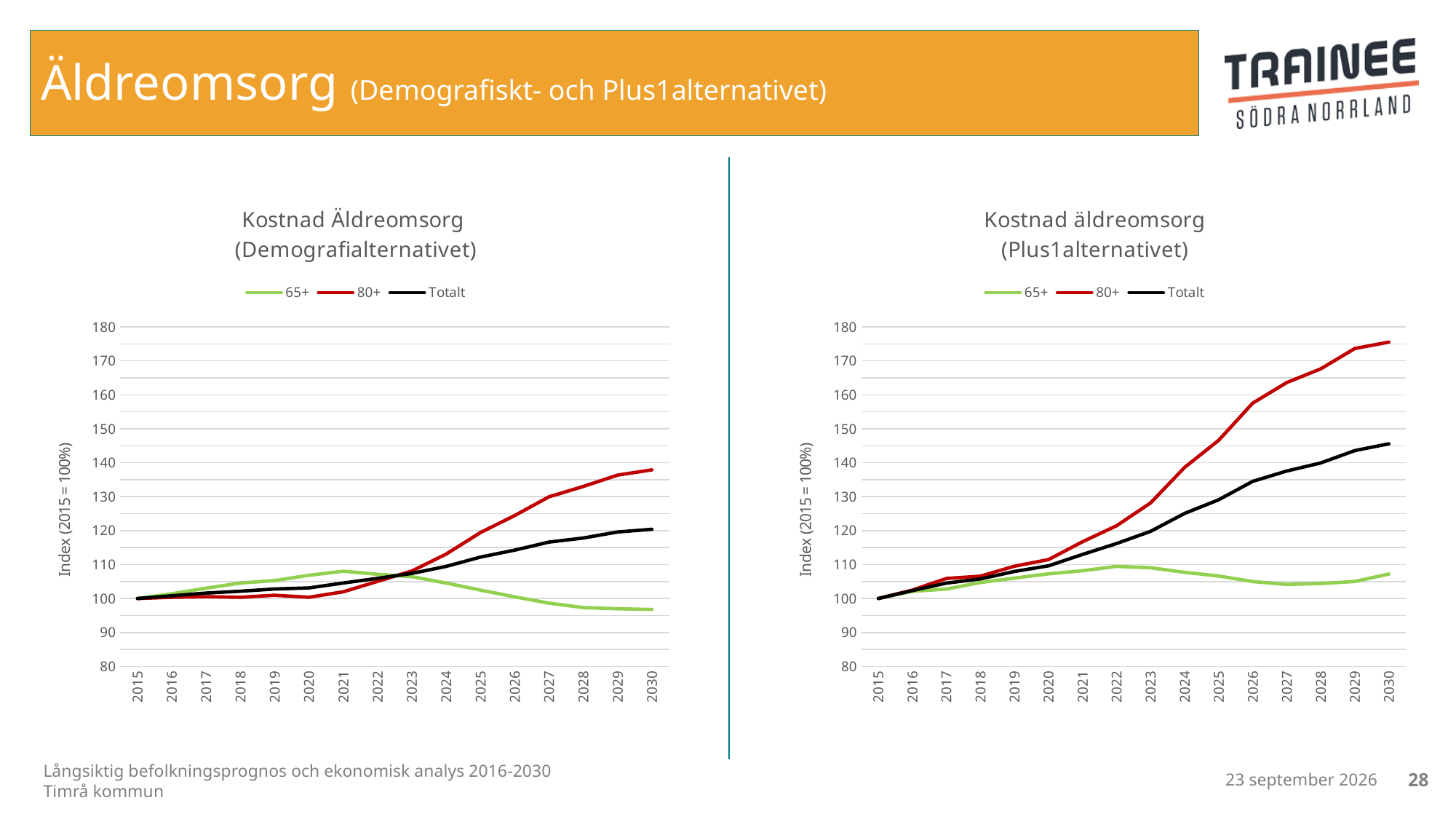
In the right chart, "Kostnad äldreomsorg (Plus1alternativet)", does the Totalt series rise or fall from 2015 to 2030? Rise What kind of chart is the left chart, "Kostnad Äldreomsorg (Demografialternativet)"? Line chart In the left chart, "Kostnad Äldreomsorg (Demografialternativet)", is the value for 65+ in 2030 greater or less than 100? less How many series does the legend of the right chart, "Kostnad äldreomsorg (Plus1alternativet)", list? 3 In the left chart, "Kostnad Äldreomsorg (Demografialternativet)", is the value for 80+ in 2030 greater or less than 130? greater Is the 80+ value in 2030 larger in the left chart (Demografialternativet) or in the right chart (Plus1alternativet)? Right chart (Plus1alternativet) What is the y-axis label of the left chart, "Kostnad Äldreomsorg (Demografialternativet)"? Index (2015 = 100%) In the right chart, "Kostnad äldreomsorg (Plus1alternativet)", is the value for 80+ in 2030 greater or less than 170? greater In the left chart, "Kostnad Äldreomsorg (Demografialternativet)", which series has the lowest value in 2030? 65+ How many years are shown on the x axis of the left chart, "Kostnad Äldreomsorg (Demografialternativet)"? 16 In the right chart, "Kostnad äldreomsorg (Plus1alternativet)", which series has the highest value in 2030? 80+